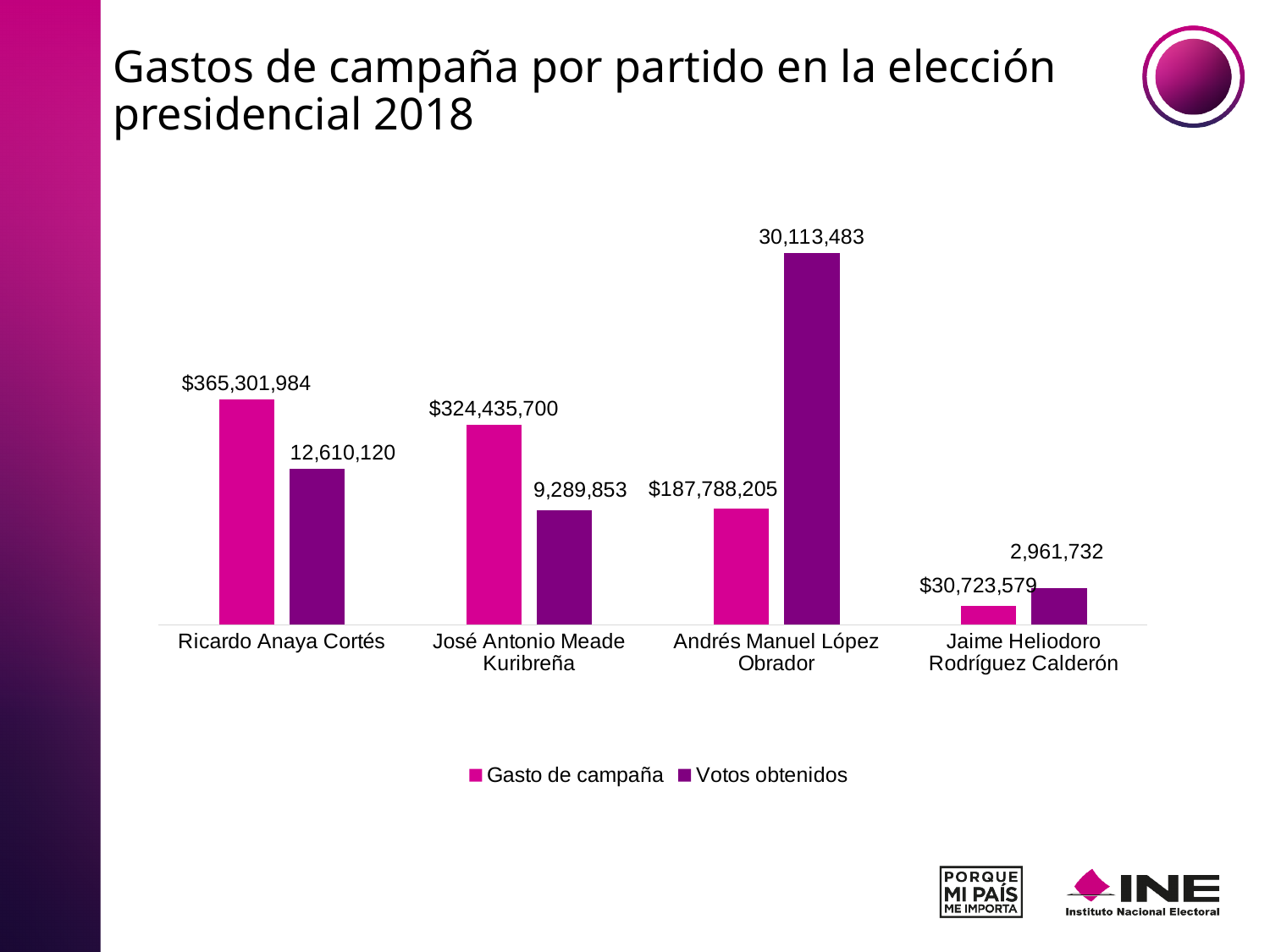
How many series does the legend list? 2 How many candidates are shown on the x axis of the chart? 4 Who had a higher Gasto de campaña, Andrés Manuel López Obrador or José Antonio Meade Kuribreña? José Antonio Meade Kuribreña How many Votos obtenidos did Andrés Manuel López Obrador receive? 30,113,483 What is the difference in Gasto de campaña between Ricardo Anaya Cortés and José Antonio Meade Kuribreña? $40,866,284 What was the Gasto de campaña for Jaime Heliodoro Rodríguez Calderón? $30,723,579 Which candidate had the highest Gasto de campaña? Ricardo Anaya Cortés Which candidate had the lowest number of Votos obtenidos? Jaime Heliodoro Rodríguez Calderón What is the difference in Votos obtenidos between Ricardo Anaya Cortés and José Antonio Meade Kuribreña? 3,320,267 How many Votos obtenidos did José Antonio Meade Kuribreña receive? 9,289,853 What was the Gasto de campaña for Ricardo Anaya Cortés? $365,301,984 Which candidate had the highest number of Votos obtenidos? Andrés Manuel López Obrador